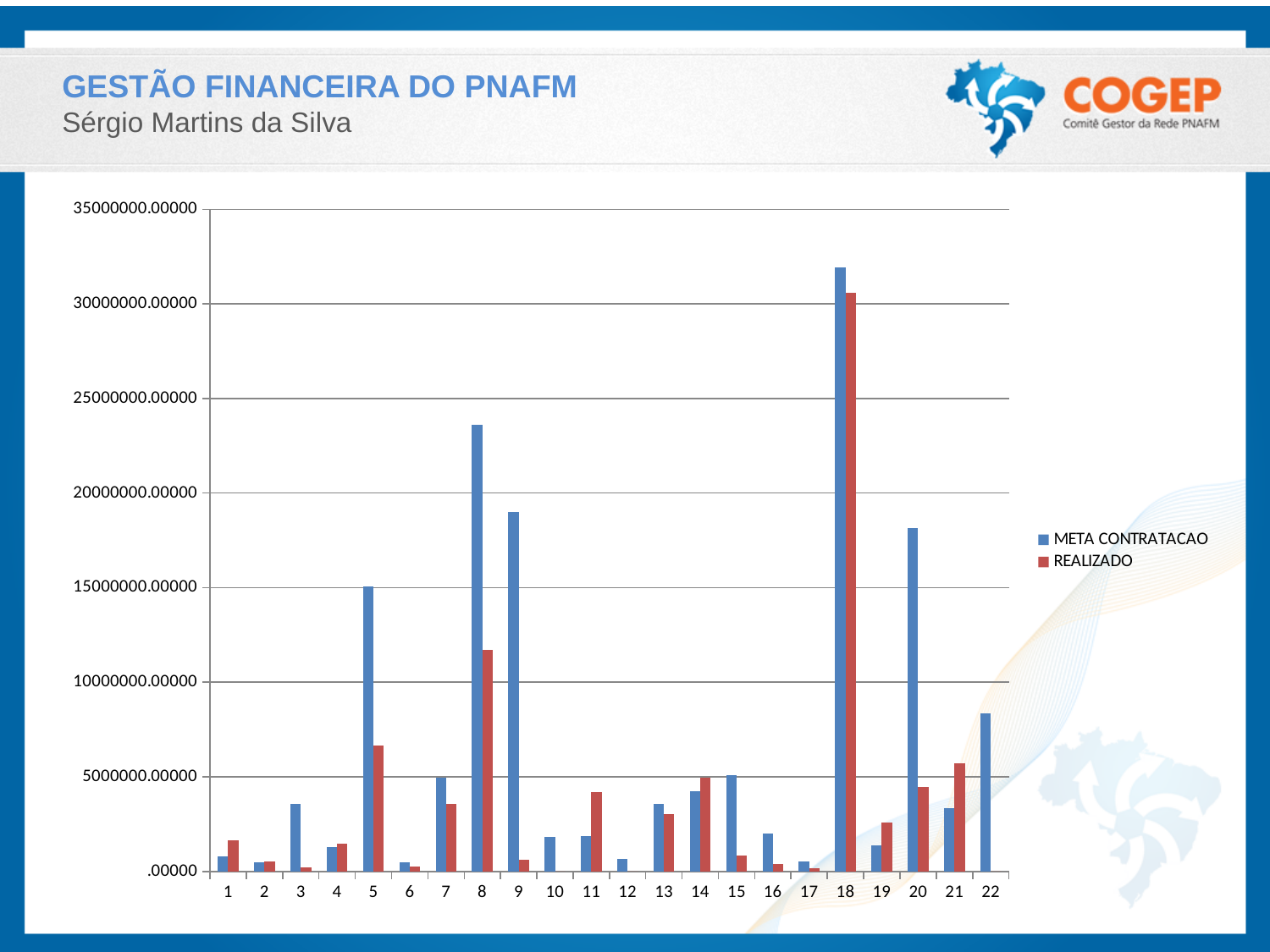
Is the META CONTRATACAO value for category 22 greater or less than 10000000? less Is the REALIZADO value for category 8 greater or less than 10000000? greater Is the META CONTRATACAO value for category 8 greater or less than 20000000? greater For category 11, which is larger: META CONTRATACAO or REALIZADO? REALIZADO How many categories are shown on the x axis? 22 Which colour represents the REALIZADO series? red Which category has the highest META CONTRATACAO value? 18 Which category has the highest REALIZADO value? 18 For category 9, which is larger: META CONTRATACAO or REALIZADO? META CONTRATACAO How many series does the legend list? 2 What kind of chart is shown on the slide? bar chart